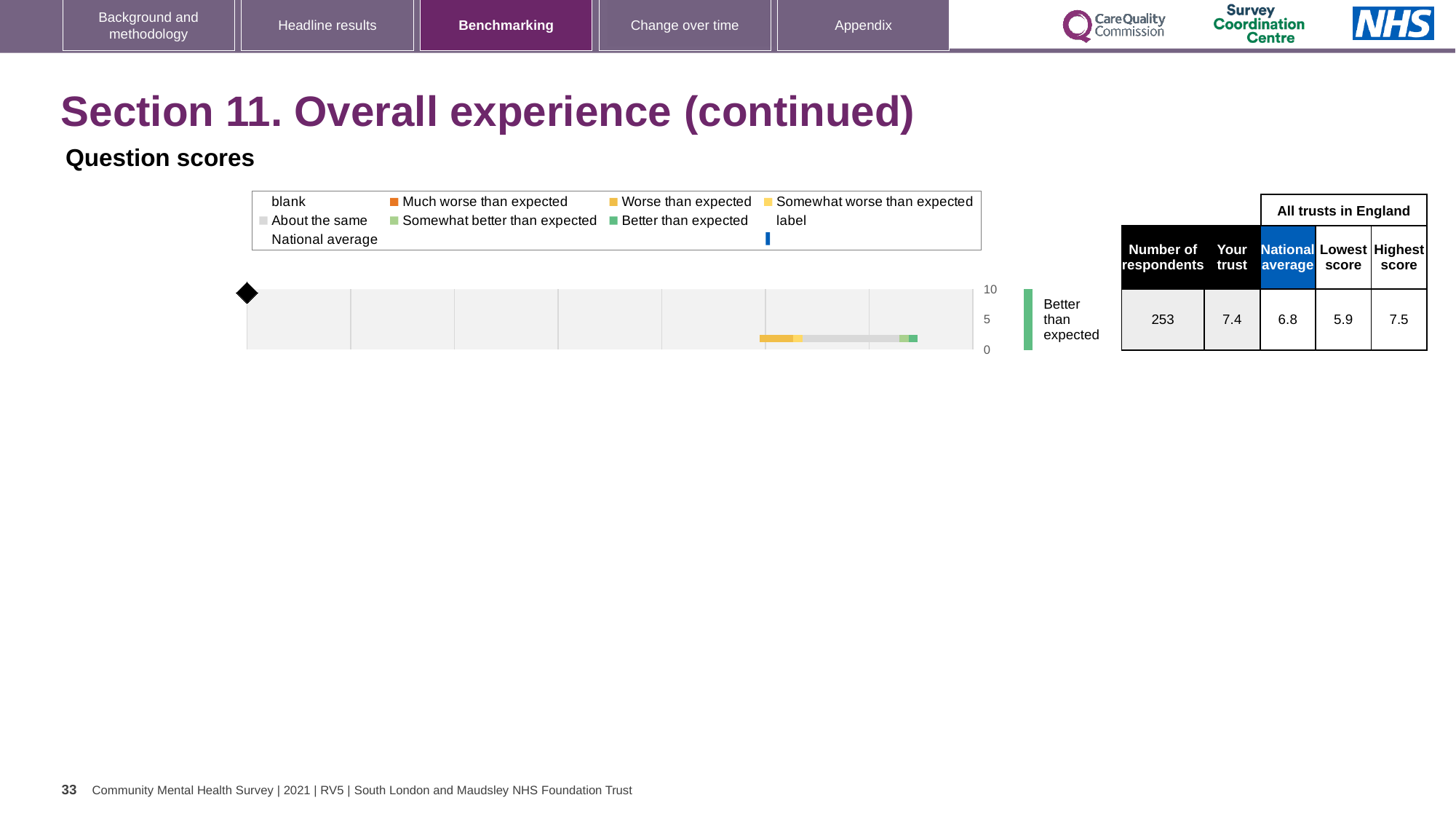
What rating label is shown next to the chart's bar? Better than expected According to the table beside the chart, what is the Highest score among all trusts in England? 7.5 Which is larger, the 'Your trust' score or the National average score? Your trust According to the table beside the chart, what is the National average score? 6.8 What is the difference between the Highest score and the Lowest score among all trusts in England? 1.6 What colour does the legend use for 'Better than expected'? green What is the difference between the 'Your trust' score and the National average score? 0.6 According to the table beside the chart, what is the Lowest score among all trusts in England? 5.9 According to the table beside the chart, what is the 'Your trust' score? 7.4 What is the highest value shown on the chart's axis? 10 What kind of chart is shown under 'Question scores'? bar chart How many respondents are reported for this question score? 253